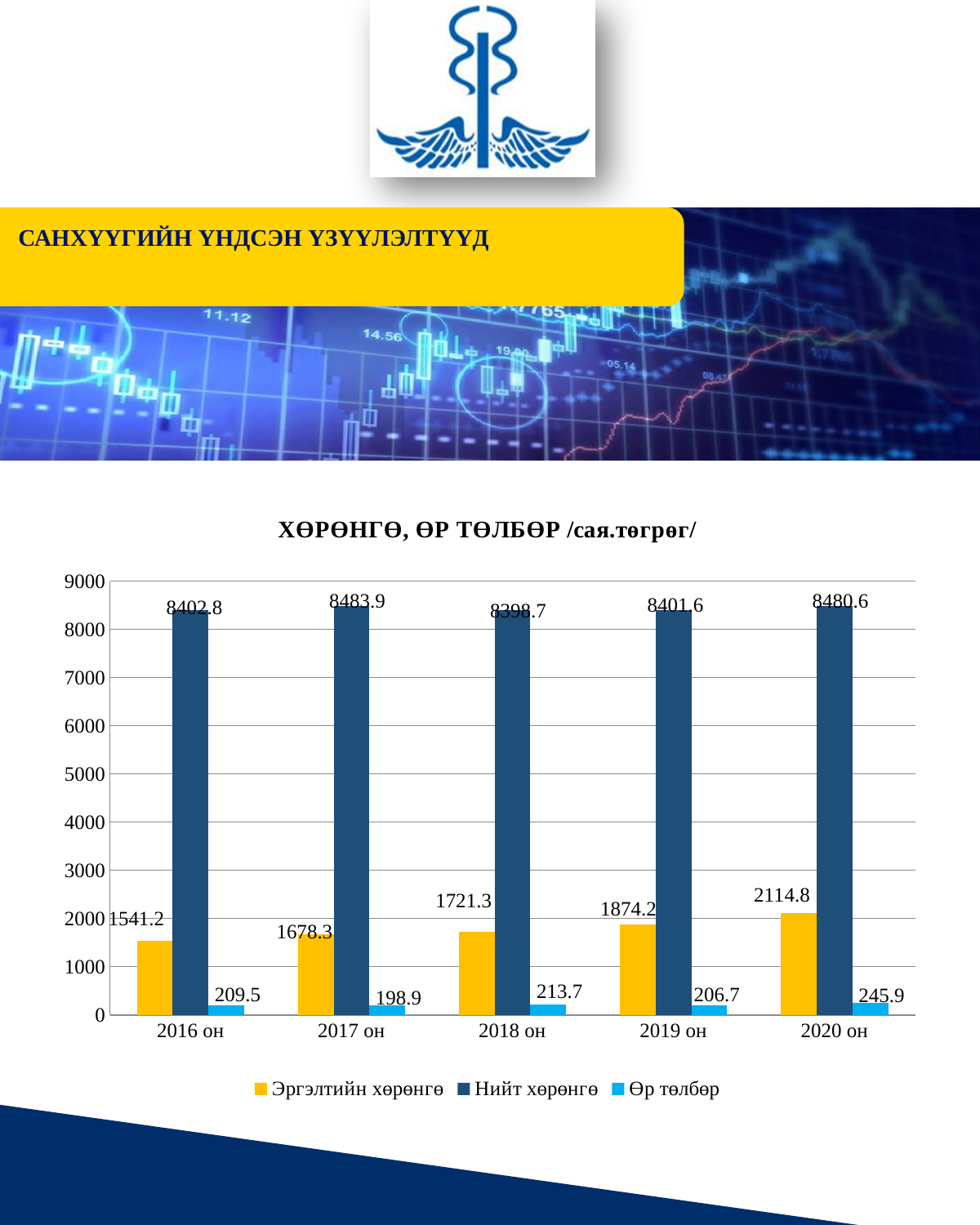
What is the value of Нийт хөрөнгө for 2017 он? 8483.9 Is the value of Нийт хөрөнгө for 2018 он greater or less than 8000? greater In which year is Өр төлбөр lowest? 2017 он What is the value of Эргэлтийн хөрөнгө for 2020 он? 2114.8 How many years are shown on the x axis? 5 Which is larger: Эргэлтийн хөрөнгө in 2019 он or in 2017 он? 2019 он What is the value of Өр төлбөр for 2018 он? 213.7 Does Эргэлтийн хөрөнгө rise or fall from 2016 он to 2020 он? rise How many series does the legend list? 3 What is the difference between Эргэлтийн хөрөнгө in 2020 он and in 2016 он? 573.6 What is the difference between Өр төлбөр in 2020 он and in 2019 он? 39.2 In which year is Эргэлтийн хөрөнгө highest? 2020 он